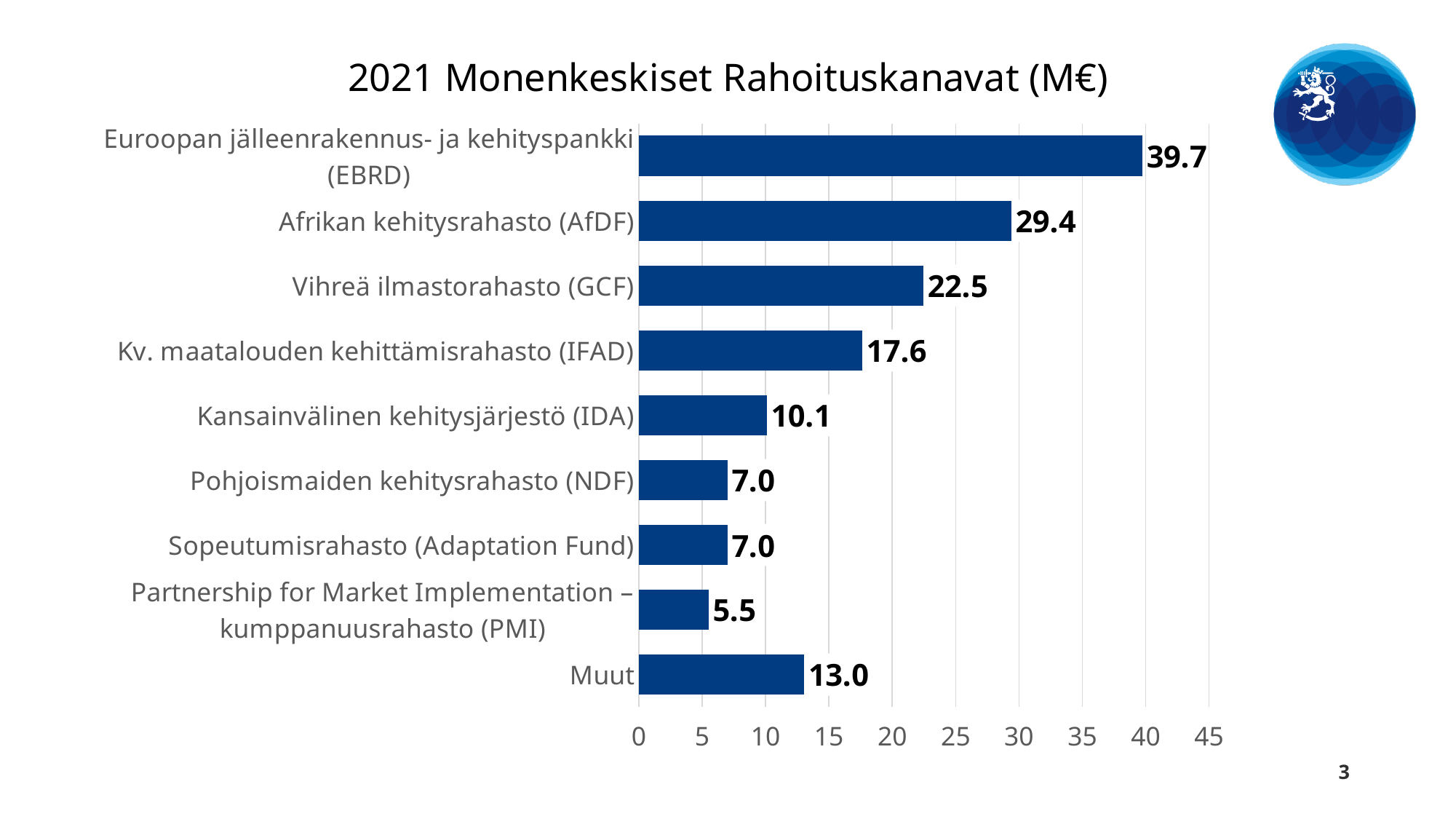
Which category has the highest value? Euroopan jälleenrakennus- ja kehityspankki (EBRD) What is the value for Kansainvälinen kehitysjärjestö (IDA)? 10.1 What is the difference between the values for Vihreä ilmastorahasto (GCF) and Kv. maatalouden kehittämisrahasto (IFAD)? 4.9 What is the difference between the values for EBRD and AfDF? 10.3 Which category has the lowest value? Partnership for Market Implementation – kumppanuusrahasto (PMI) What kind of chart is shown on the slide? bar chart Is the value for Vihreä ilmastorahasto (GCF) greater or less than 20? greater What is the title of the chart? 2021 Monenkeskiset Rahoituskanavat (M€) How many categories are shown in the chart? 9 What is the value for Afrikan kehitysrahasto (AfDF)? 29.4 Which is larger, the value for Muut or the value for Kansainvälinen kehitysjärjestö (IDA)? Muut What is the value for Muut? 13.0